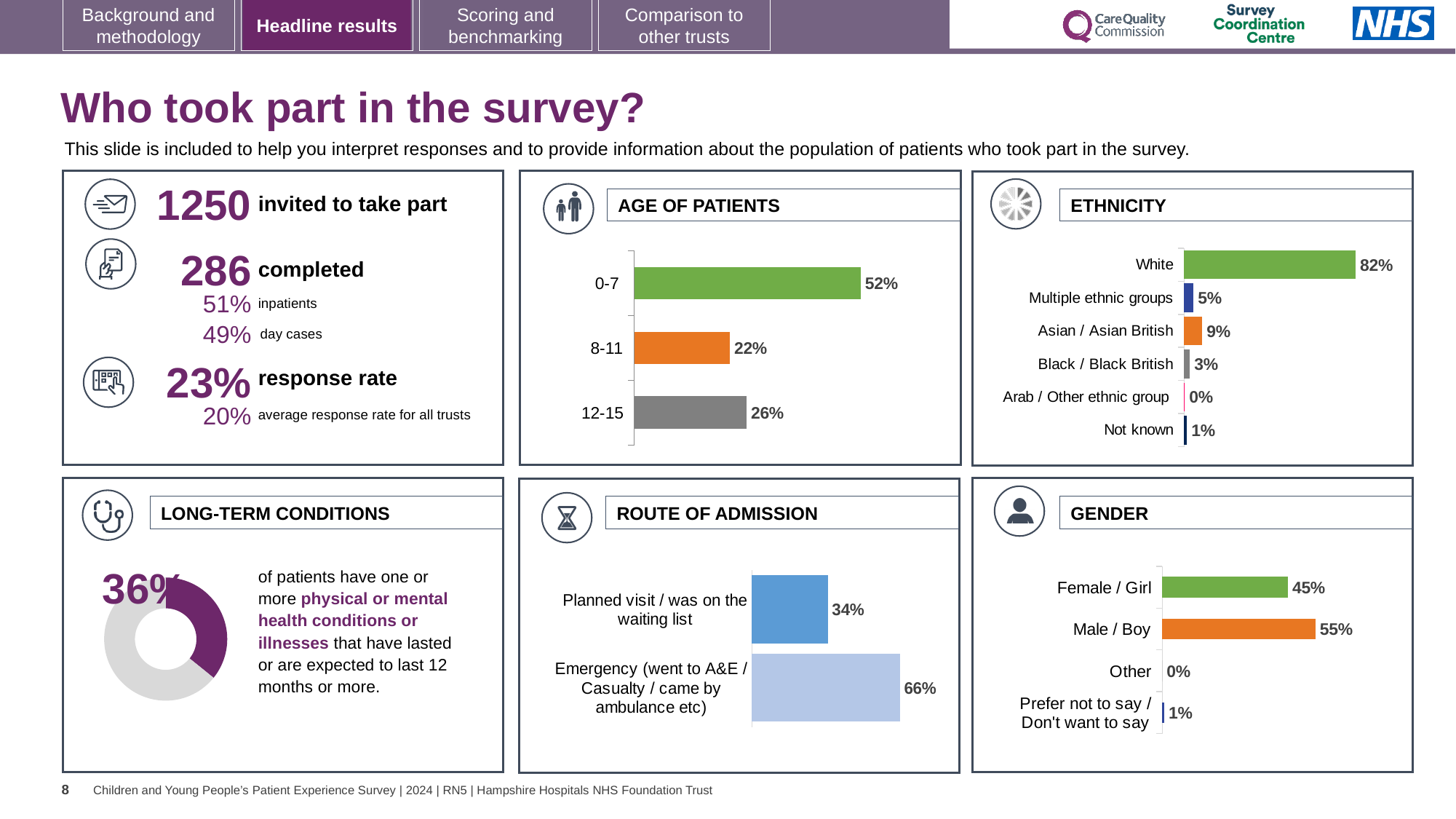
In the AGE OF PATIENTS chart, what percentage of patients were aged 0-7? 52% In the AGE OF PATIENTS chart, what is the difference between the 0-7 and 12-15 percentages? 26% In the ROUTE OF ADMISSION chart, what is the difference between the Emergency and Planned visit percentages? 32% In the AGE OF PATIENTS chart, which age group has the lowest percentage? 8-11 In the GENDER chart, which is larger: Female / Girl or Male / Boy? Male / Boy In the GENDER chart, what percentage of patients were Male / Boy? 55% How many categories are shown in the ETHNICITY chart? 6 In the ETHNICITY chart, what percentage of patients were Asian / Asian British? 9% What kind of chart is used in the LONG-TERM CONDITIONS panel? Doughnut chart In the ETHNICITY chart, which category has the highest percentage? White In the ROUTE OF ADMISSION chart, what percentage of patients came via Emergency (went to A&E / Casualty / came by ambulance etc)? 66% In the ETHNICITY chart, which is larger: Multiple ethnic groups or Black / Black British? Multiple ethnic groups